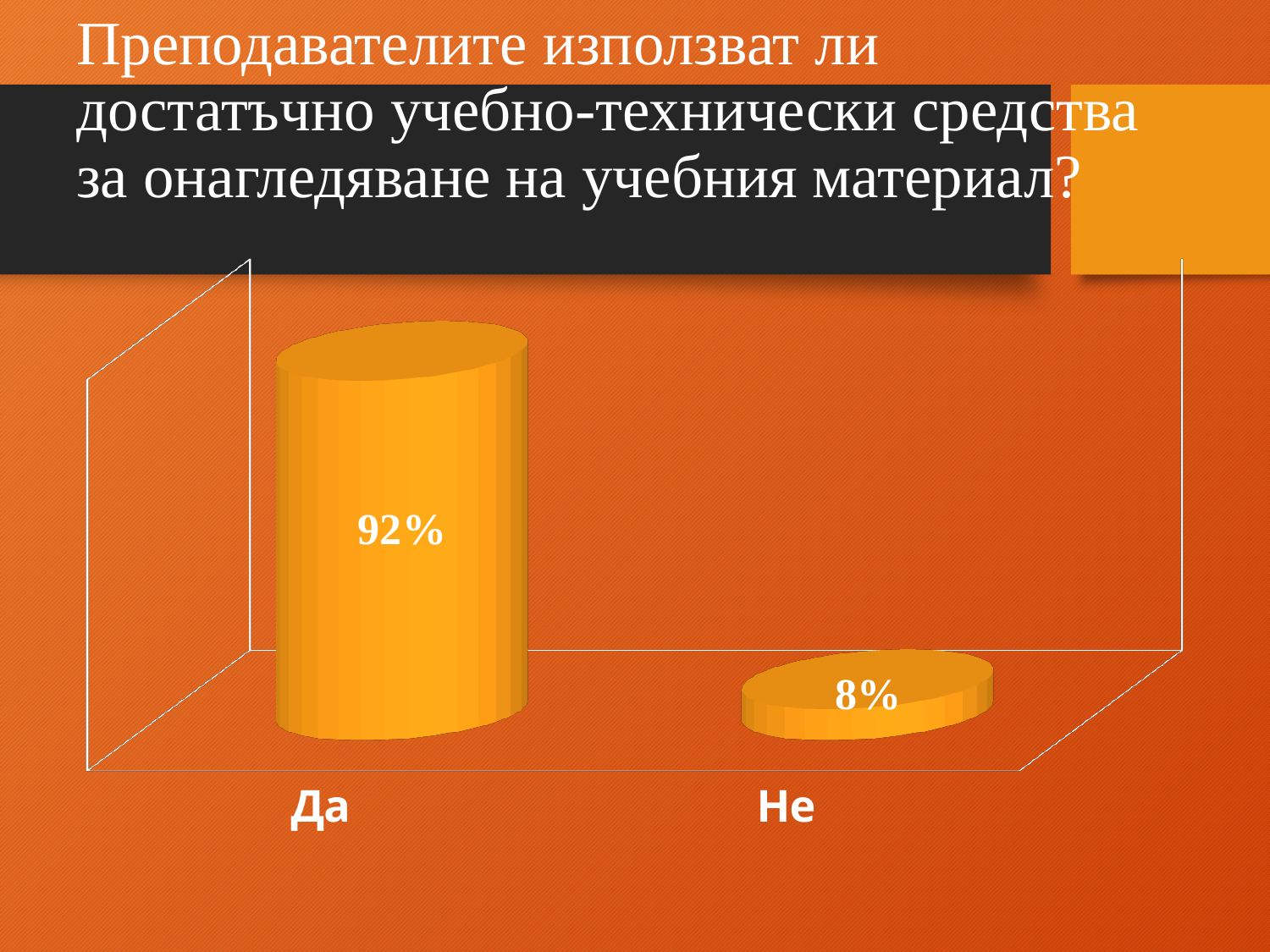
Which is larger, the value for "Да" or the value for "Не"? Да What is the total of the two values shown in the chart? 100% What kind of chart is shown on the slide? Bar chart What is the difference between the values for "Да" and "Не"? 84% What is the value for "Не"? 8% Which category has the lowest value? Не What question does the slide title ask about the chart? Преподавателите използват ли достатъчно учебно-технически средства за онагледяване на учебния материал? What is the value for "Да"? 92% How many categories are shown in the chart? 2 What colour are the bars in the chart? Orange Which category has the highest value? Да